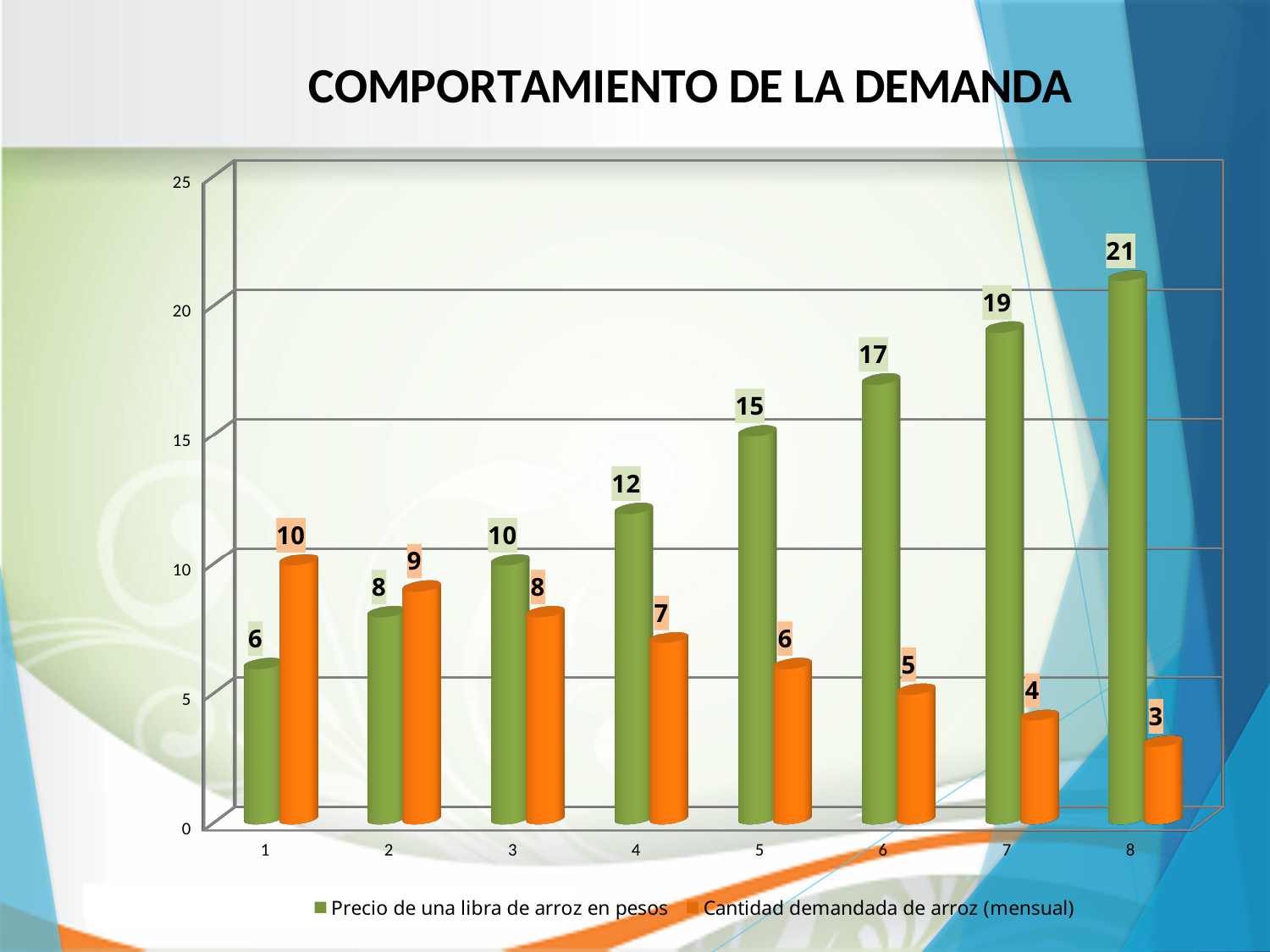
What is the difference between 'Precio de una libra de arroz en pesos' and 'Cantidad demandada de arroz (mensual)' for category 7? 15 Which category has the lowest value for 'Cantidad demandada de arroz (mensual)'? 8 What is the value of 'Precio de una libra de arroz en pesos' for category 5? 15 How many series does the legend list? 2 Do the values of 'Cantidad demandada de arroz (mensual)' rise or fall from category 1 to category 8? fall How many categories are shown on the x axis? 8 What kind of chart is shown on the slide? bar chart Is the value of 'Precio de una libra de arroz en pesos' for category 6 greater or less than 15? greater For category 1, which series has the larger value: 'Precio de una libra de arroz en pesos' or 'Cantidad demandada de arroz (mensual)'? Cantidad demandada de arroz (mensual) What is the value of 'Cantidad demandada de arroz (mensual)' for category 2? 9 Which category has the highest value for 'Precio de una libra de arroz en pesos'? 8 What is the title of the chart? COMPORTAMIENTO DE LA DEMANDA